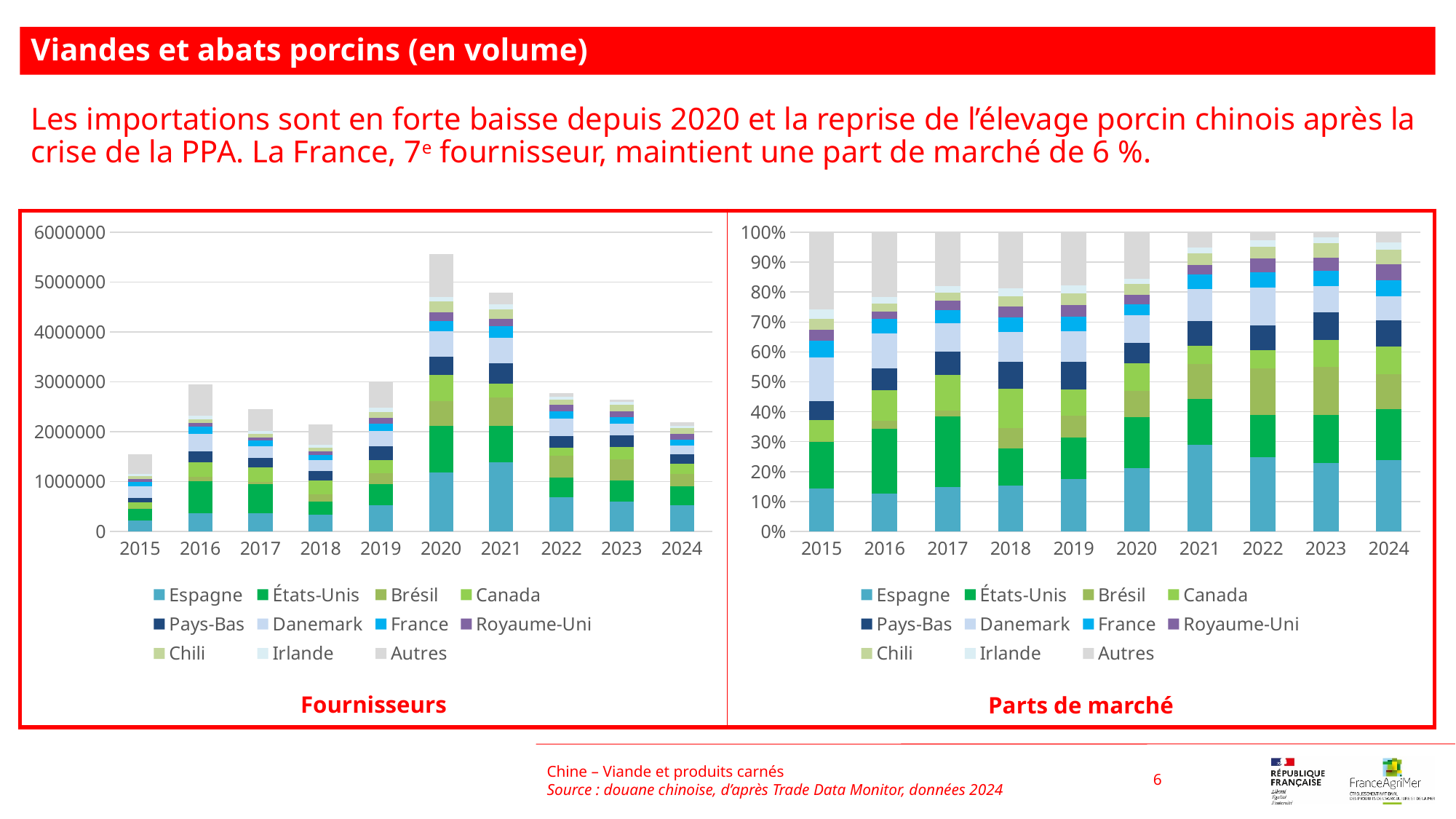
In the Parts de marché chart, is the share of Espagne in 2021 greater or less than 20%? greater In the Fournisseurs chart, do the total bars rise or fall from 2020 to 2024? fall In the Fournisseurs chart, which year has the larger total bar, 2021 or 2022? 2021 In the Fournisseurs chart, is the total for 2024 greater or less than 3000000? less How many years are shown on the x axis of the Fournisseurs chart? 10 In the Fournisseurs chart, which year has the tallest total bar? 2020 In the Fournisseurs chart, which year has the lowest total bar? 2015 What is the first entry in the legend of the Fournisseurs chart? Espagne In the Parts de marché chart, which year has the larger share for Espagne, 2015 or 2021? 2021 What kind of chart is the Fournisseurs chart on the left? Stacked bar chart How many series does the legend of the Parts de marché chart list? 11 In the Fournisseurs chart, is the total for 2020 greater or less than 5000000? greater